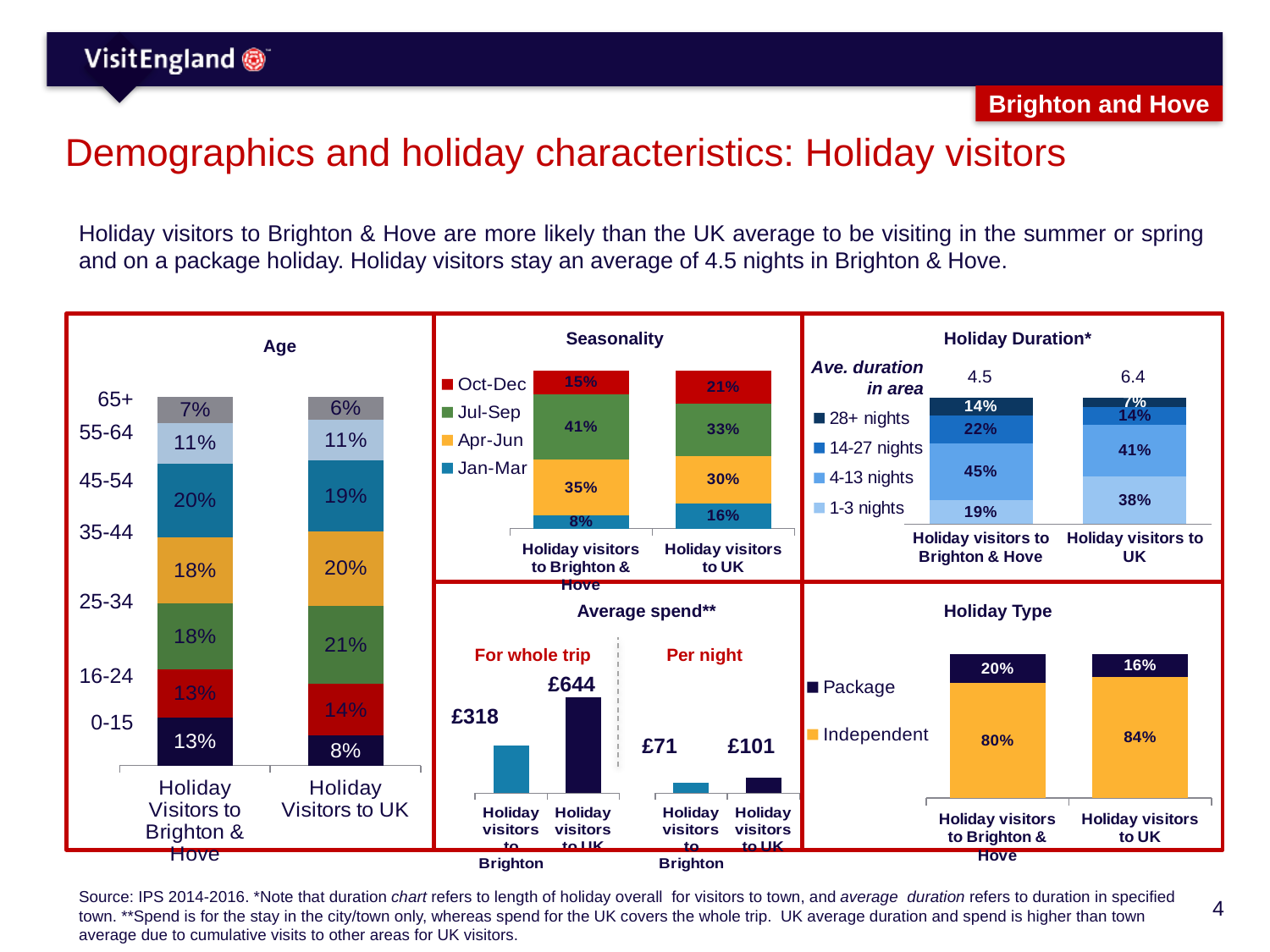
In the Average spend chart, what is the difference in per night spend between holiday visitors to UK and holiday visitors to Brighton? £30 In the Average spend chart, what is the average spend for the whole trip for holiday visitors to Brighton? £318 In the Holiday Type chart, what percentage of holiday visitors to Brighton & Hove are on a package holiday? 20% In the Age chart, what is the difference between the 0-15 share for holiday visitors to Brighton & Hove and for holiday visitors to UK? 5% In the Seasonality chart, what percentage of holiday visitors to UK visit in Jan-Mar? 16% In the Age chart, which age group is the smallest share of holiday visitors to Brighton & Hove? 65+ In the Holiday Duration chart, what percentage of holiday visitors to Brighton & Hove stay 4-13 nights? 45% In the Holiday Type chart, which group has the larger Independent share, holiday visitors to Brighton & Hove or holiday visitors to UK? Holiday visitors to UK In the Age chart, what percentage of holiday visitors to UK are aged 25-34? 21% In the Seasonality chart, how many series does the legend list? 4 In the Seasonality chart, what percentage of holiday visitors to Brighton & Hove visit in Jul-Sep? 41% In the Holiday Duration chart, what is the average duration in area for holiday visitors to UK? 6.4